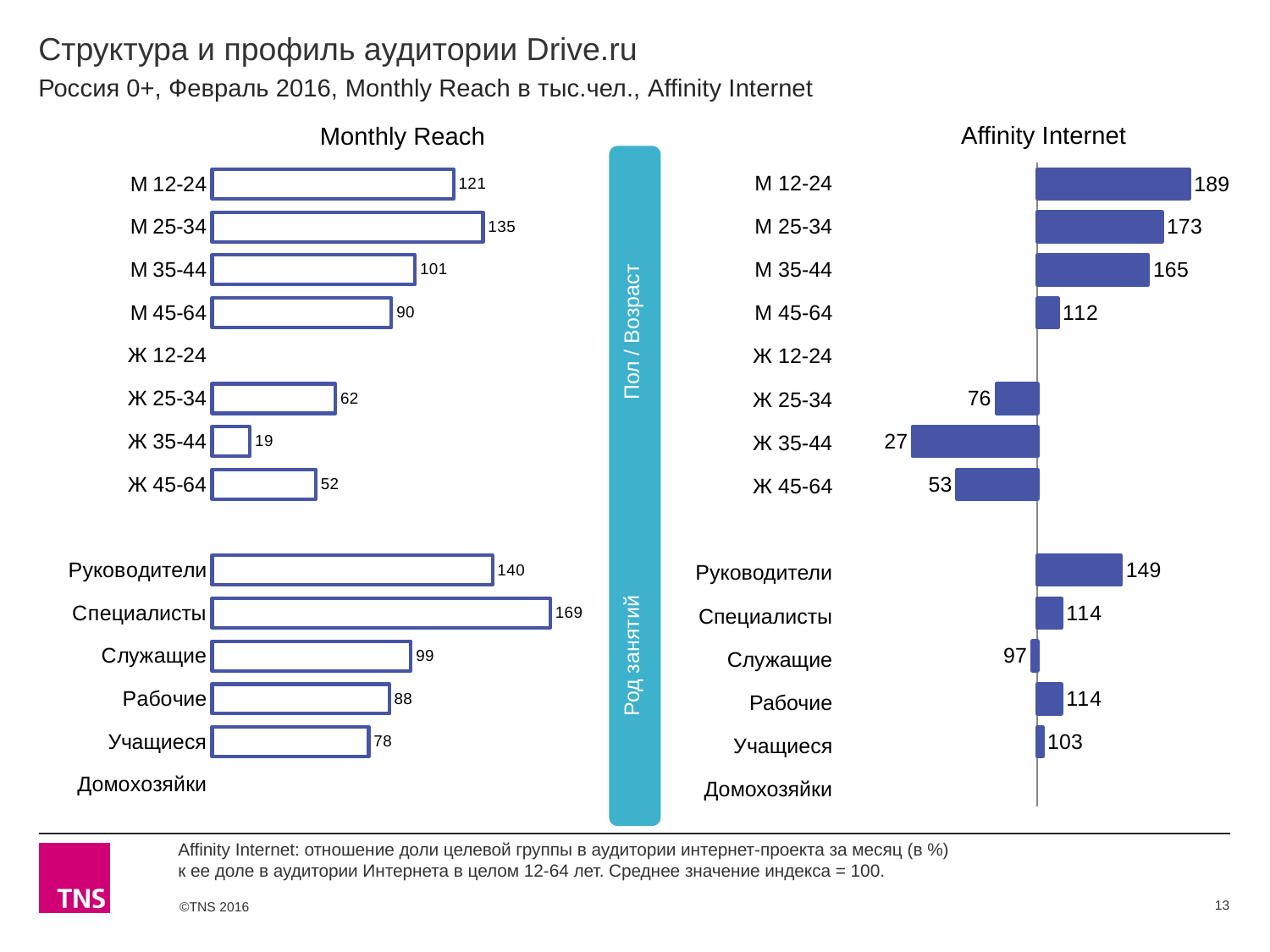
On the Affinity Internet chart, what is the value for Ж 35-44? 27 On the Affinity Internet chart, which labelled category has the lowest value? Ж 35-44 On the Monthly Reach chart, what is the value for Специалисты? 169 On the Monthly Reach chart, which labelled category has the lowest value? Ж 35-44 On the Affinity Internet chart, which category has the highest value? М 12-24 On the Monthly Reach chart, what is the difference between Руководители and Рабочие? 52 On the Affinity Internet chart, which is larger: Руководители or Учащиеся? Руководители On the Affinity Internet chart, what is the difference between М 25-34 and М 45-64? 61 On the Monthly Reach chart, what is the value for М 25-34? 135 What type of chart is the Affinity Internet chart? Bar chart On the Monthly Reach chart, which category has the highest value? Специалисты On the Affinity Internet chart, what is the value for М 12-24? 189